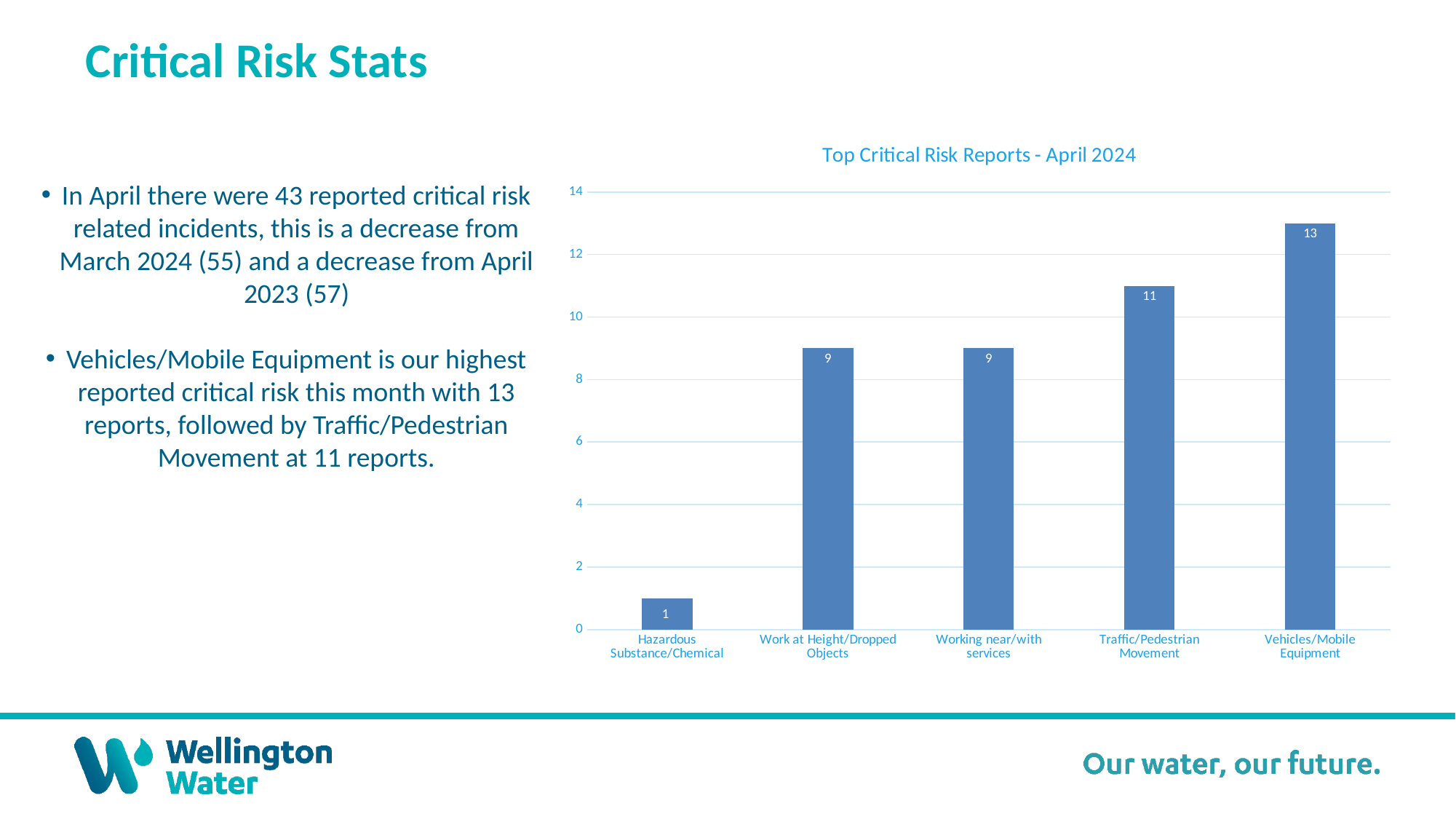
Is the value for Vehicles/Mobile Equipment greater or less than 12? greater Which category has the highest value? Vehicles/Mobile Equipment What is the value for Vehicles/Mobile Equipment? 13 What kind of chart is shown on the slide? Bar chart What is the difference between Vehicles/Mobile Equipment and Traffic/Pedestrian Movement? 2 What is the value for Traffic/Pedestrian Movement? 11 How many categories are shown on the chart? 5 Which category has the lowest value? Hazardous Substance/Chemical What is the value for Work at Height/Dropped Objects? 9 What is the title of the chart? Top Critical Risk Reports - April 2024 What is the value for Hazardous Substance/Chemical? 1 Which is larger, Working near/with services or Traffic/Pedestrian Movement? Traffic/Pedestrian Movement